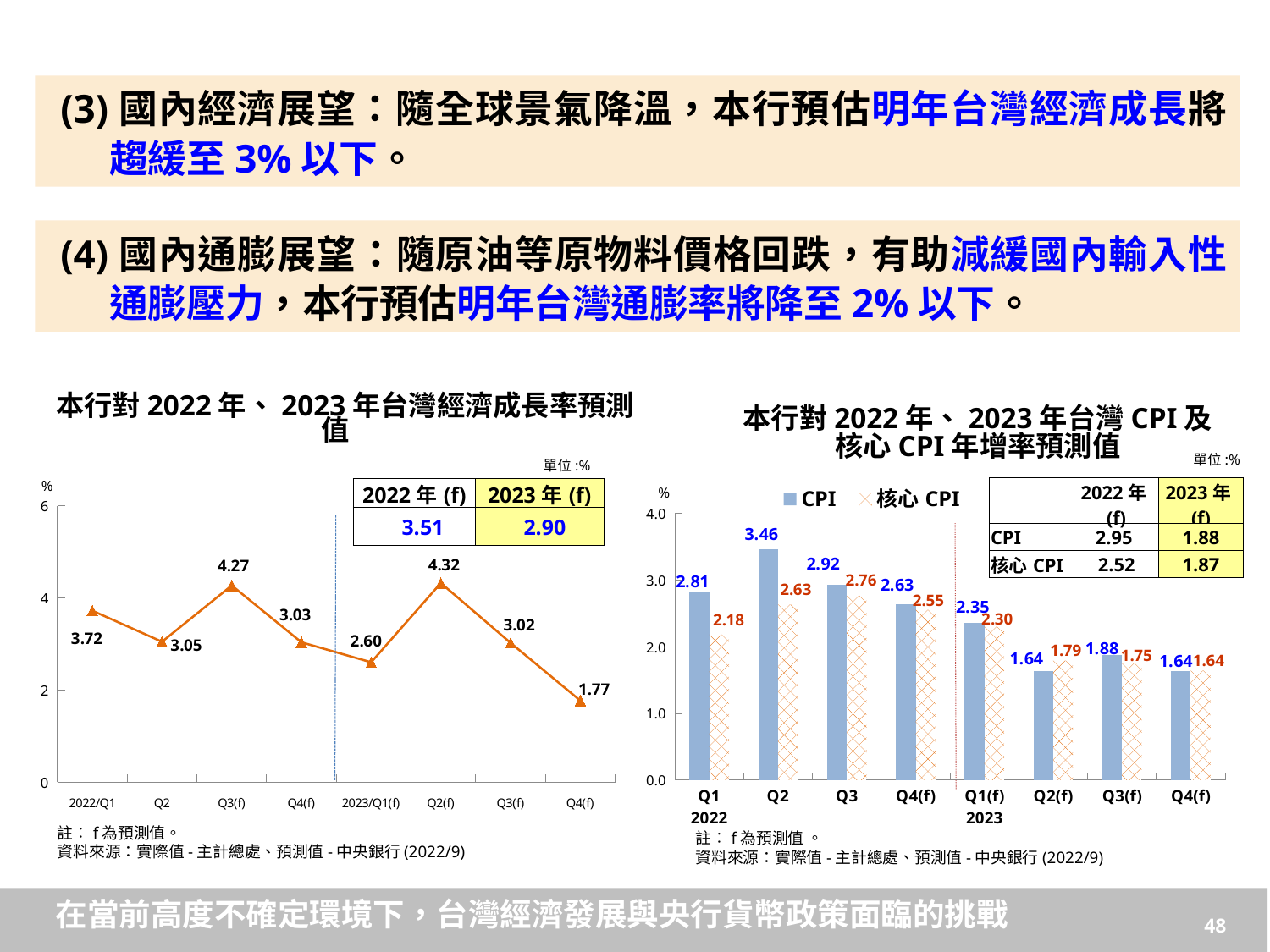
What type of chart is the left chart (economic growth rate forecast)? Line chart In the right chart (CPI and core CPI), what is the difference between CPI and 核心 CPI for Q1 2022? 0.63 In the left chart (economic growth rate forecast), what is the difference between the 2022/Q3(f) value and the 2022/Q2 value? 1.22 In the right chart's table, what is the 核心 CPI forecast for 2023 年 (f)? 1.87 In the right chart (CPI and core CPI), what is the CPI value for Q2 2022? 3.46 In the left chart's table, what is the forecast value for 2023 年 (f)? 2.90 In the left chart (economic growth rate forecast), how many quarterly data points are plotted? 8 In the right chart (CPI and core CPI), what is the 核心 CPI value for Q3 2022? 2.76 In the right chart (CPI and core CPI), which is larger for Q1(f) 2023: CPI or 核心 CPI? CPI In the right chart (CPI and core CPI), how many series does the legend list? 2 In the left chart (economic growth rate forecast), what is the value for 2023/Q2(f)? 4.32 In the left chart (economic growth rate forecast), which quarter has the lowest value? Q4(f) of 2023